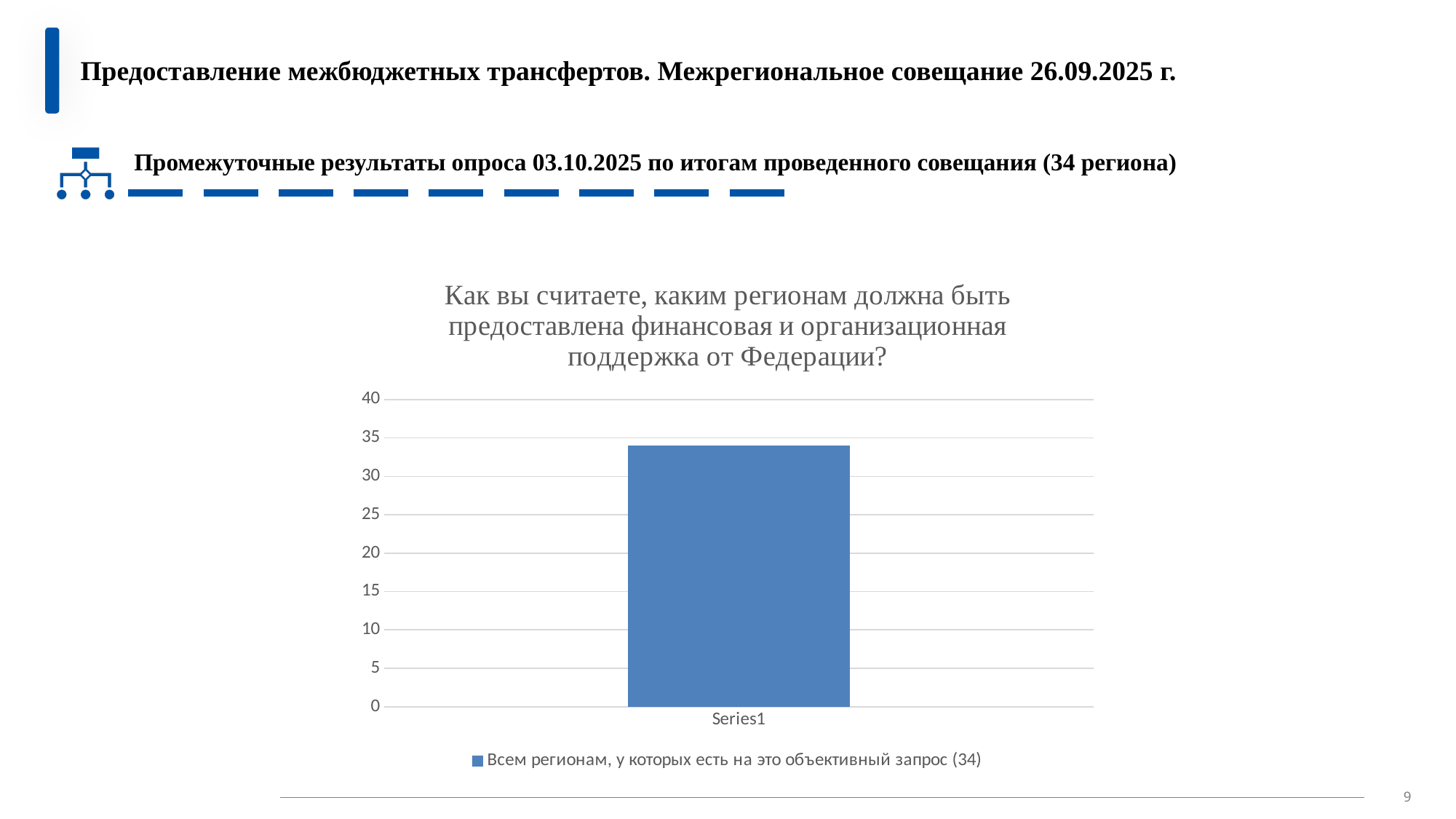
How many bars are plotted in the chart? 1 Is the value of the bar for Series1 greater or less than 20? greater How many series does the chart legend list? 1 What is the category label shown under the bar on the x axis? Series1 Is the value of the bar for Series1 greater or less than 30? greater What number is shown in parentheses in the legend entry of the chart? 34 What is the highest value shown on the chart's vertical axis? 40 What kind of chart is shown on the slide? bar chart